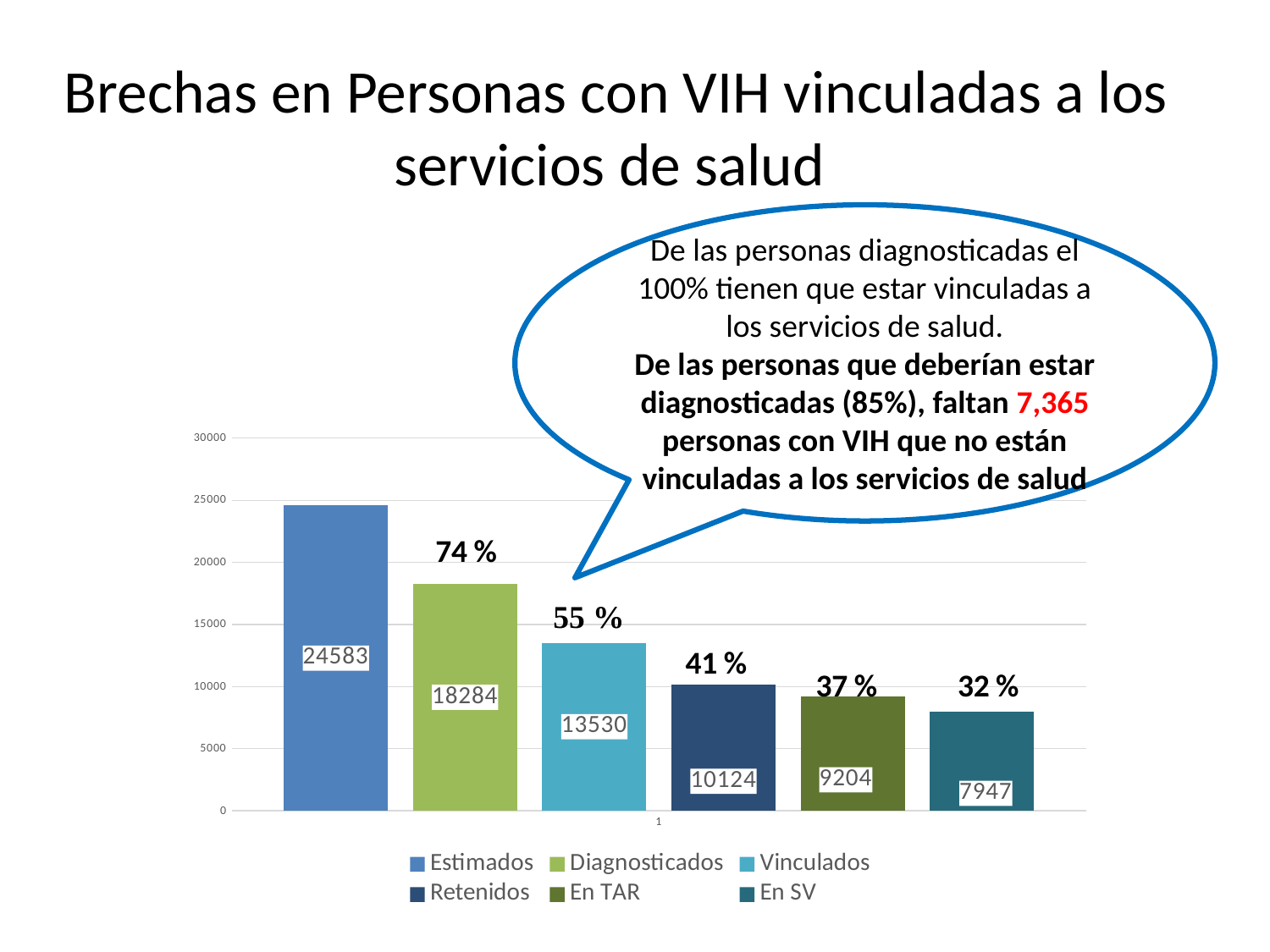
What is the value for En SV? 7947 What is the difference between the values for Retenidos and En TAR? 920 How many series does the legend list? 6 Which series has the highest value? Estimados What is the value for Diagnosticados? 18284 What kind of chart is shown on the slide? Bar chart Which is larger, the value for Vinculados or the value for Retenidos? Vinculados What percentage label is shown above the Retenidos bar? 41 % What is the value for Vinculados? 13530 What is the difference between the values for Estimados and Diagnosticados? 6299 What is the value for Estimados? 24583 Which series has the lowest value? En SV